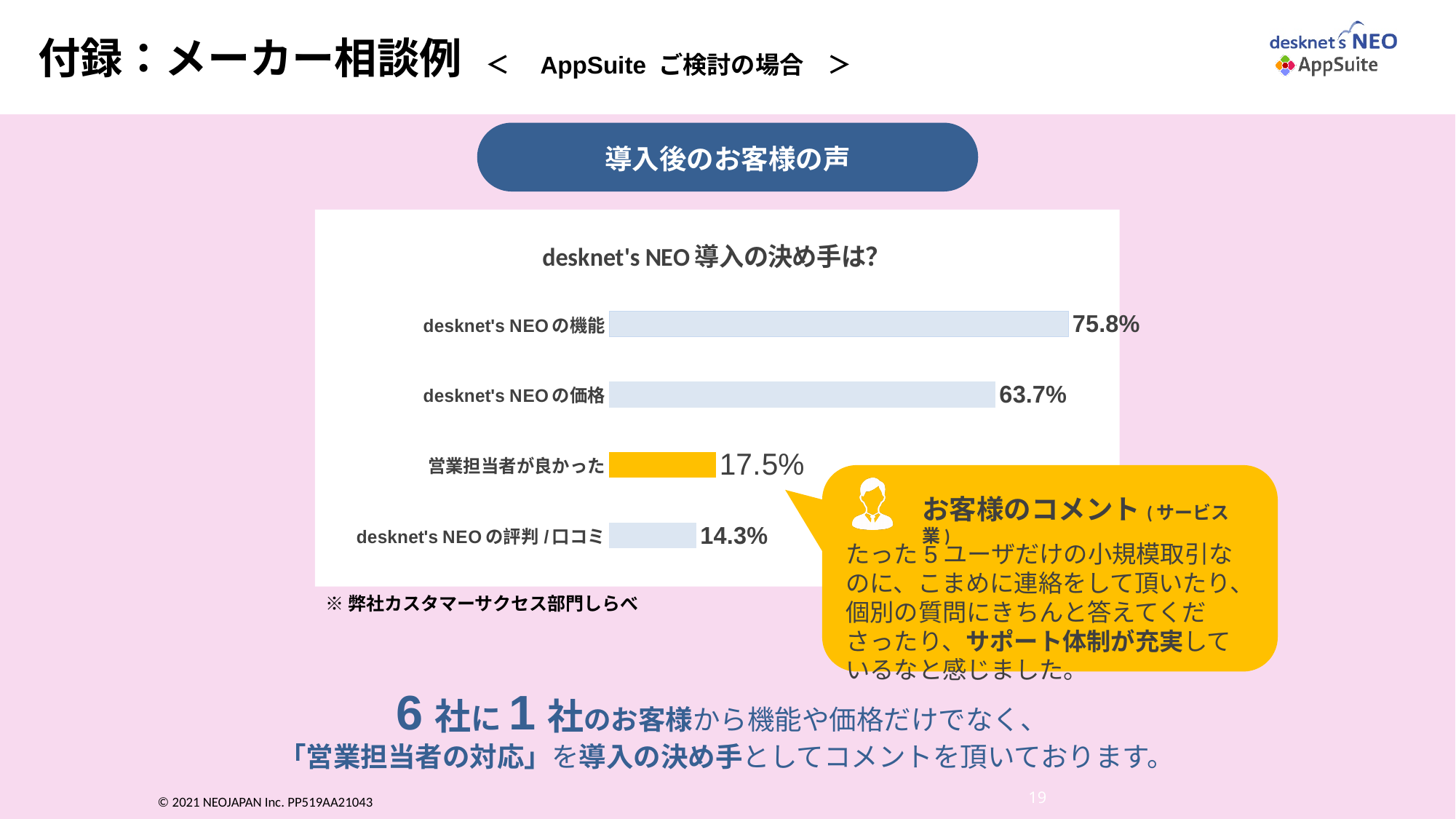
What is the value for desknet's NEO の価格? 63.7% Which category has the lowest value? desknet's NEO の評判/口コミ Which category has the highest value? desknet's NEO の機能 What is the value for desknet's NEO の評判/口コミ? 14.3% What is the value for 営業担当者が良かった? 17.5% What is the value for desknet's NEO の機能? 75.8% What is the difference between the values for 営業担当者が良かった and desknet's NEO の評判/口コミ? 3.2% What is the title of the chart? desknet's NEO 導入の決め手は? What kind of chart is shown on the slide? Bar chart How many categories are shown in the chart? 4 Which is larger, the value for desknet's NEO の価格 or the value for 営業担当者が良かった? desknet's NEO の価格 What is the difference between the values for desknet's NEO の機能 and desknet's NEO の価格? 12.1%